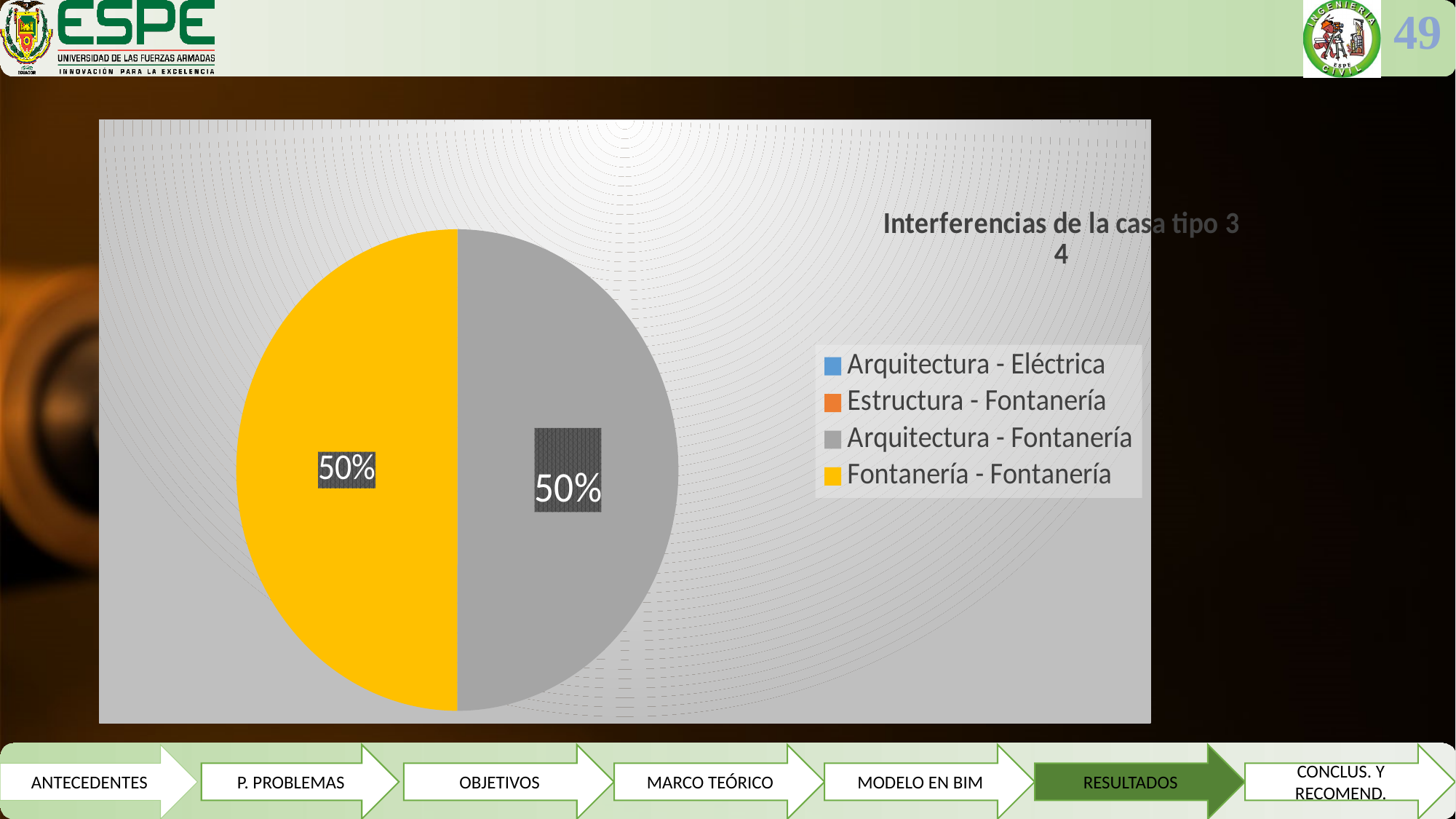
Which colour represents Fontanería - Fontanería in the chart? yellow How many entries does the chart legend list? 4 What is the title of the chart? Interferencias de la casa tipo 3 4 How many slices are visible in the pie chart? 2 What kind of chart is shown on the slide? pie chart What share of the pie does the Arquitectura - Fontanería slice represent? 50% What is the combined share of the Fontanería - Fontanería and Arquitectura - Fontanería slices? 100% Is the share for Arquitectura - Fontanería larger than, smaller than, or equal to the share for Fontanería - Fontanería? equal What is the difference between the Fontanería - Fontanería share and the Arquitectura - Fontanería share? 0% What share of the pie does the Fontanería - Fontanería slice represent? 50%